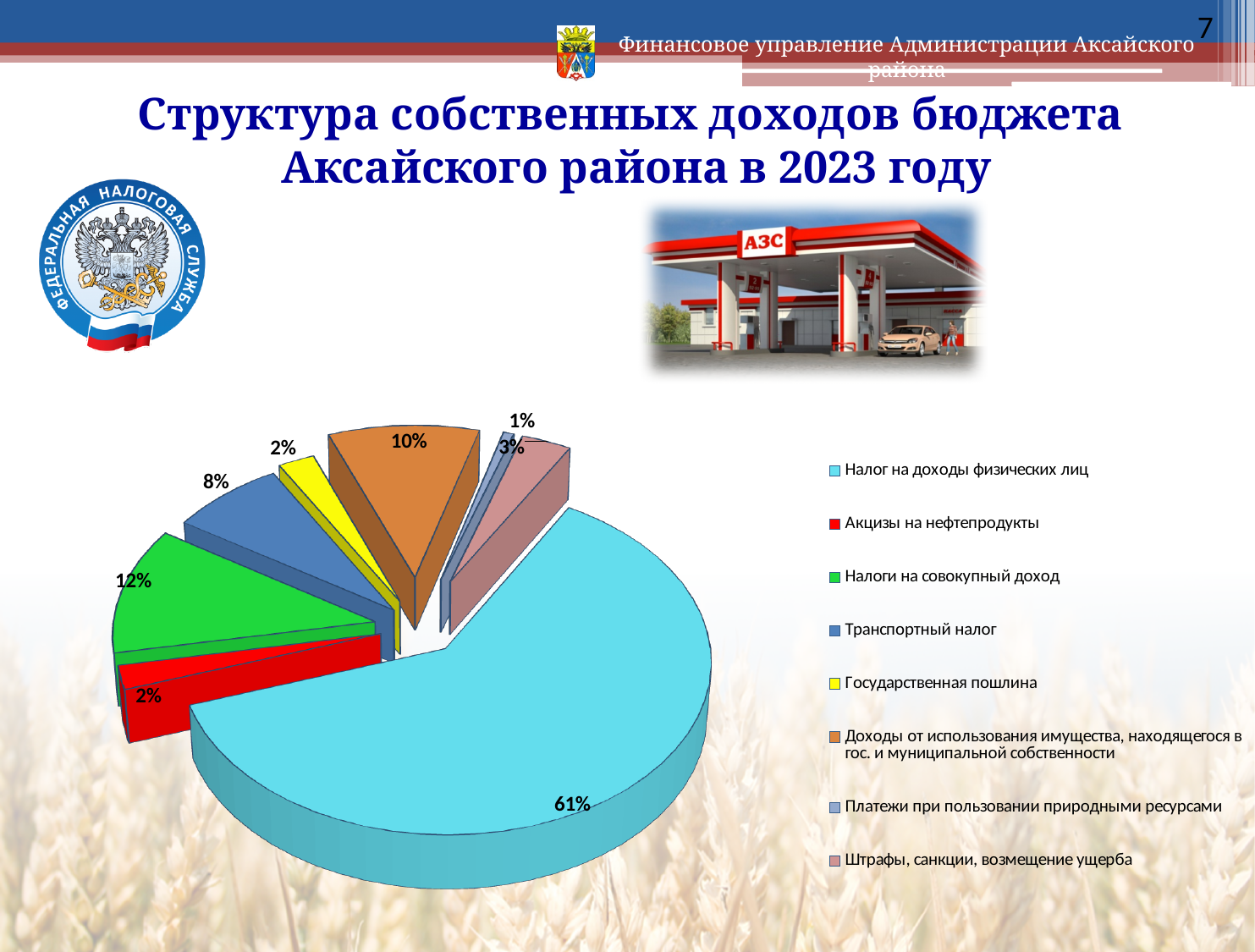
Which category has the smallest share of the pie? Платежи при пользовании природными ресурсами What is the difference in percentage points between "Налоги на совокупный доход" and "Транспортный налог"? 4 What share of the pie does "Штрафы, санкции, возмещение ущерба" have? 3% What share of the pie does "Налоги на совокупный доход" have? 12% What colour is the slice for "Акцизы на нефтепродукты"? red What share of the pie does "Доходы от использования имущества, находящегося в гос. и муниципальной собственности" have? 10% What kind of chart is shown on the slide? pie chart Which is larger: the share for "Доходы от использования имущества, находящегося в гос. и муниципальной собственности" or the share for "Транспортный налог"? Доходы от использования имущества, находящегося в гос. и муниципальной собственности Which category has the largest share of the pie? Налог на доходы физических лиц How many categories does the legend list? 8